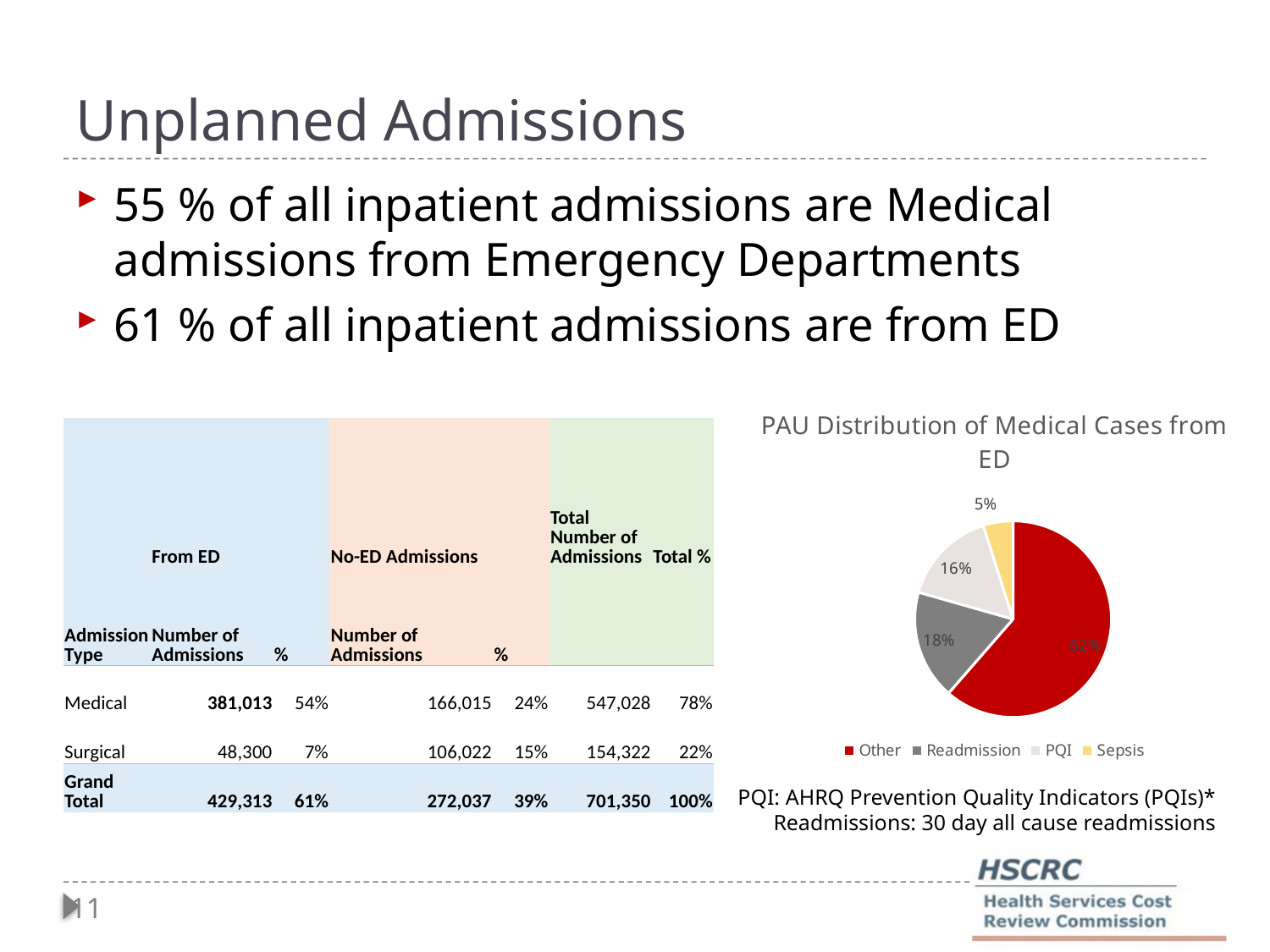
What share of the pie does Readmission account for? 18% What is the difference in percentage points between the Readmission slice and the Sepsis slice? 13% What kind of chart is shown on the slide? pie chart Which category has the largest slice of the pie? Other What share of the pie does Sepsis account for? 5% Which category has the smallest slice of the pie? Sepsis What is the difference in percentage points between the PQI slice and the Sepsis slice? 11% What is the title of the pie chart? PAU Distribution of Medical Cases from ED What share of the pie does PQI account for? 16% How many categories does the legend of the pie chart list? 4 Which slice is larger, Readmission or PQI? Readmission Which category is shown in yellow in the pie chart? Sepsis